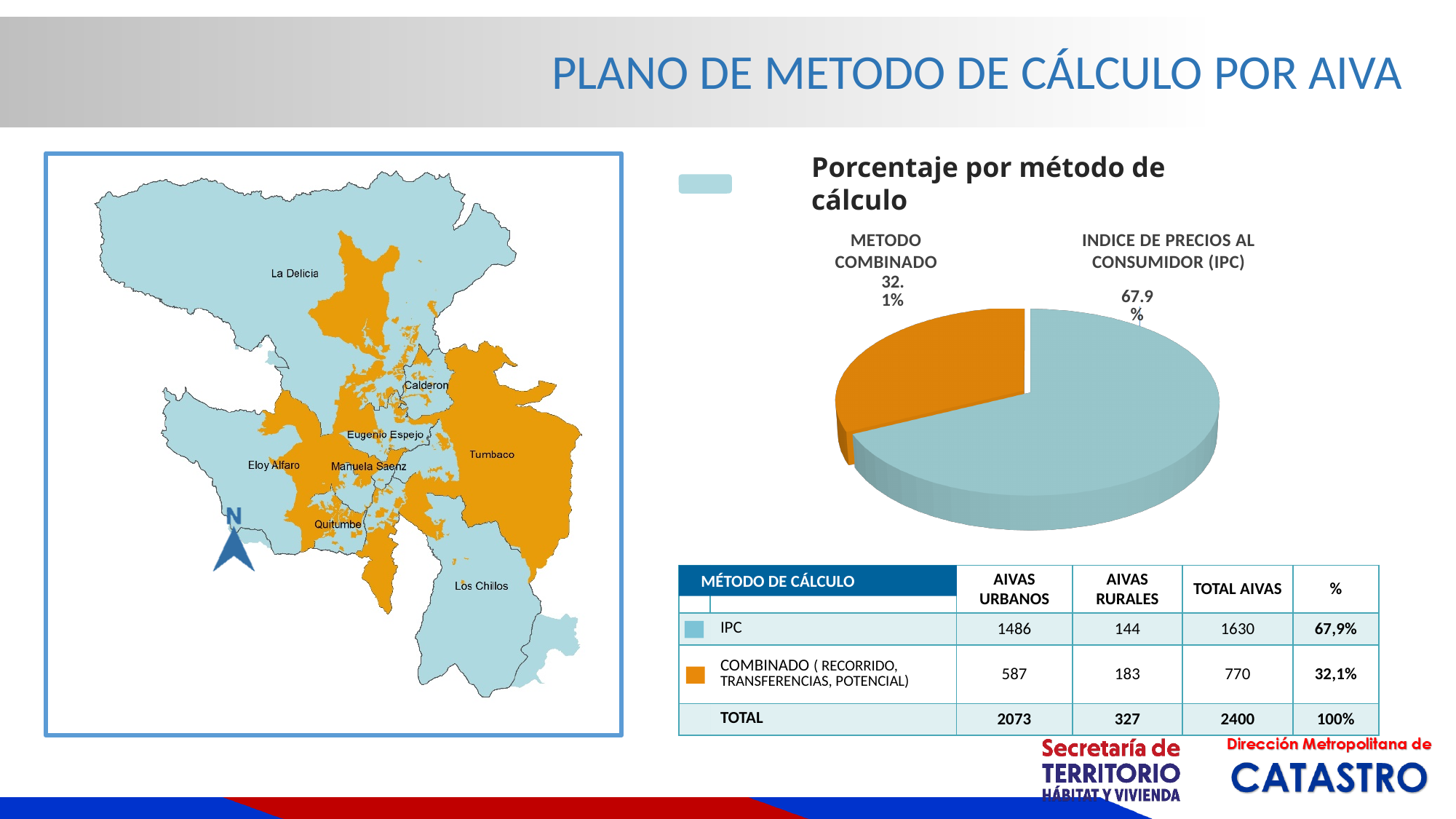
How many slices does the pie chart have? 2 What share of the pie does the METODO COMBINADO slice represent? 32.1% What is the title of the pie chart? Porcentaje por método de cálculo Which slice of the pie chart is the smallest? METODO COMBINADO In the pie chart, what percentage is shown for METODO COMBINADO? 32.1% Which slice of the pie chart is the largest? INDICE DE PRECIOS AL CONSUMIDOR (IPC) In the pie chart, what percentage is shown for INDICE DE PRECIOS AL CONSUMIDOR (IPC)? 67.9% In the pie chart, which is larger: the share for IPC or the share for METODO COMBINADO? IPC What kind of chart is shown under the title "Porcentaje por método de cálculo"? Pie chart By how many percentage points does the IPC slice exceed the METODO COMBINADO slice in the pie chart? 35.8 percentage points What colour is the METODO COMBINADO slice in the pie chart? Orange